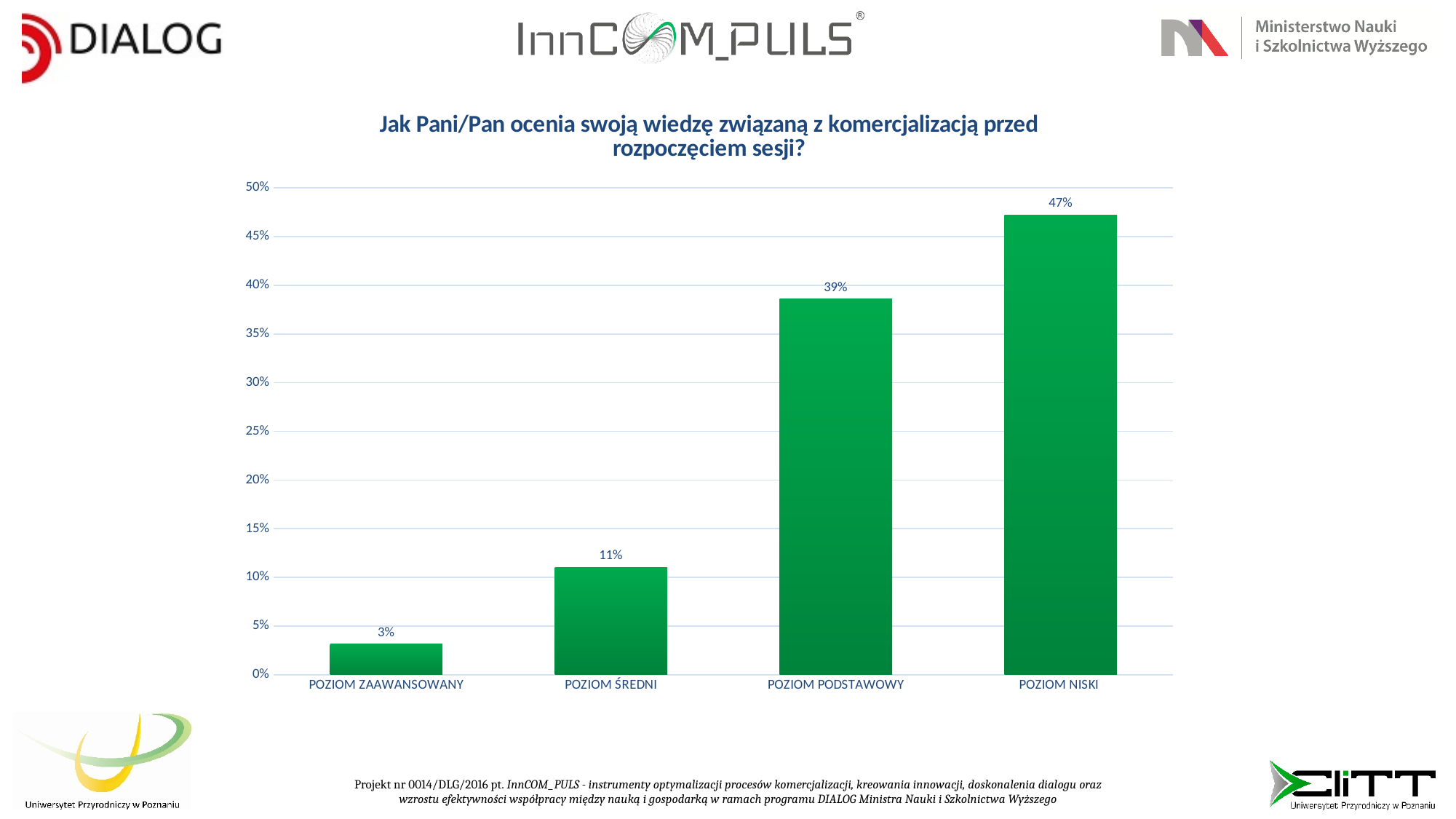
Which category has the highest value? POZIOM NISKI What is the value for POZIOM NISKI? 47% Which category has the lowest value? POZIOM ZAAWANSOWANY What is the value for POZIOM ZAAWANSOWANY? 3% What is the value for POZIOM ŚREDNI? 11% Do the values rise or fall from left to right along the x axis? rise How many categories are shown on the x axis? 4 What kind of chart is shown on the slide? bar chart Which is larger, the value for POZIOM ŚREDNI or the value for POZIOM PODSTAWOWY? POZIOM PODSTAWOWY What is the difference between the values for POZIOM NISKI and POZIOM PODSTAWOWY? 8% What is the value for POZIOM PODSTAWOWY? 39% Is the value for POZIOM PODSTAWOWY greater or less than 35%? greater